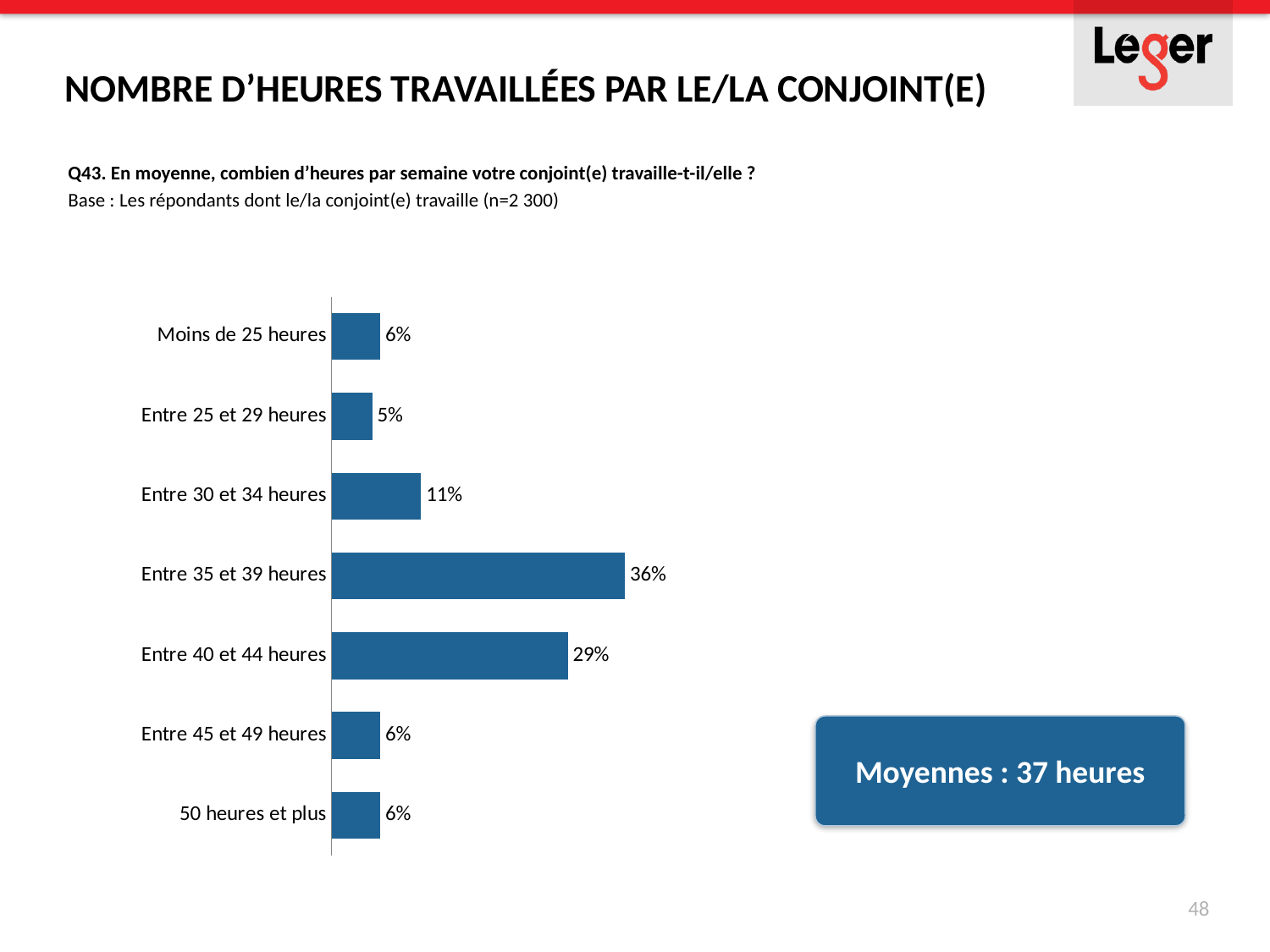
What is the difference between the values for 'Entre 30 et 34 heures' and 'Entre 25 et 29 heures'? 6% What is the difference between the values for 'Entre 35 et 39 heures' and 'Entre 40 et 44 heures'? 7% What kind of chart is shown on the slide? Bar chart What average number of hours is stated in the box next to the chart? 37 heures Which category has the lowest value? Entre 25 et 29 heures What is the value for 'Moins de 25 heures'? 6% What percentage of respondents said their spouse works between 35 and 39 hours per week? 36% How many categories are shown in the chart? 7 Which category has the highest value? Entre 35 et 39 heures What is the value for 'Entre 40 et 44 heures'? 29% What is the value for 'Entre 30 et 34 heures'? 11% Which is larger, the value for 'Entre 30 et 34 heures' or the value for '50 heures et plus'? Entre 30 et 34 heures